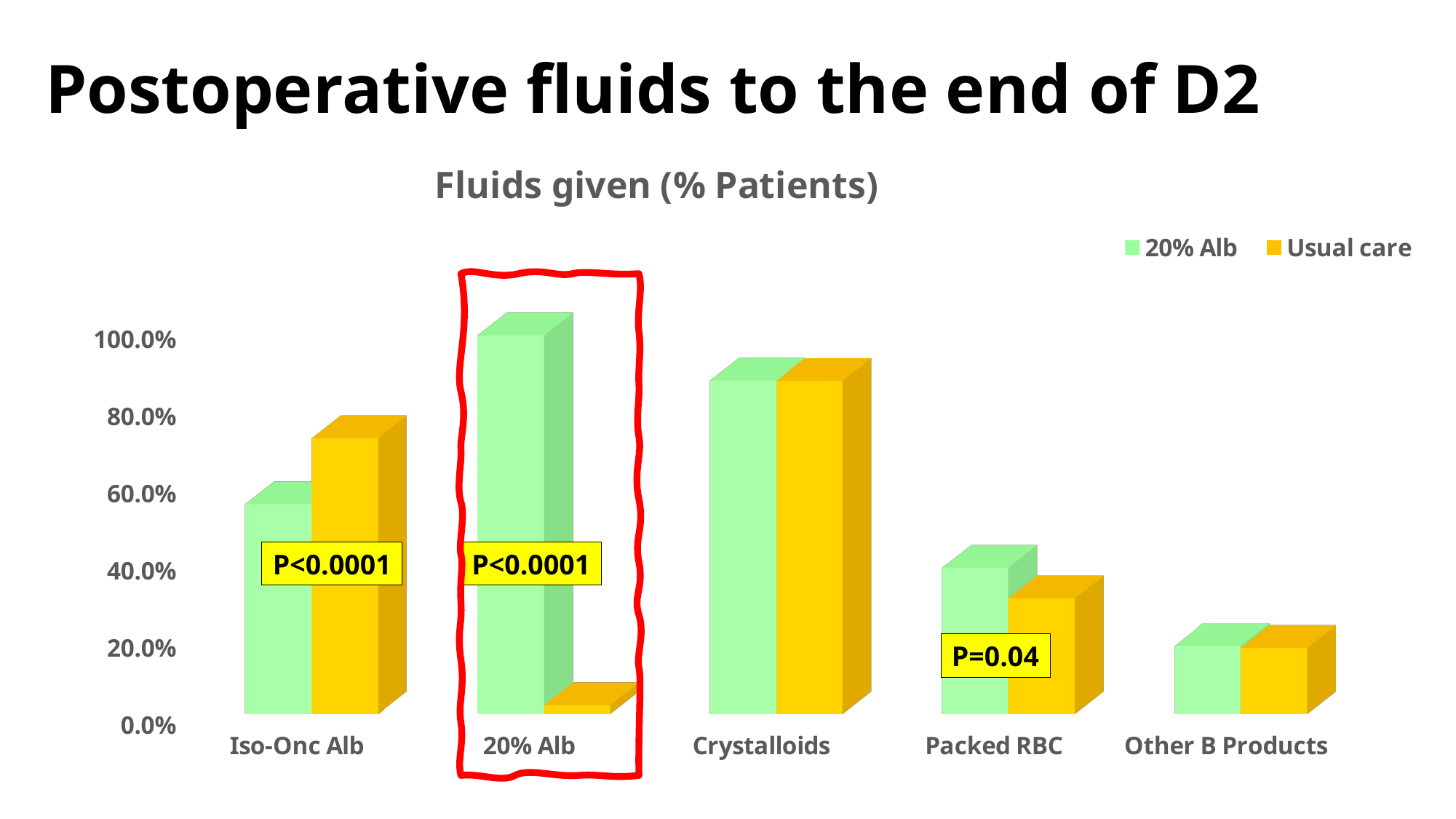
How many series does the chart legend list? 2 Which category is outlined with a red box on the chart? 20% Alb For Packed RBC, which series has the larger value, 20% Alb or Usual care? 20% Alb Is the Usual care value for Iso-Onc Alb greater or less than 60.0%? greater In which category is the 20% Alb series bar the highest? 20% Alb In which category is the Usual care bar the lowest? 20% Alb How many categories are shown on the x axis of the chart? 5 Is the Usual care value for 20% Alb greater or less than 20.0%? less Is the 20% Alb series value for Crystalloids greater or less than 80.0%? greater What is the title of the chart? Fluids given (% Patients) For Iso-Onc Alb, which series has the larger value, 20% Alb or Usual care? Usual care What kind of chart is shown on the slide? bar chart